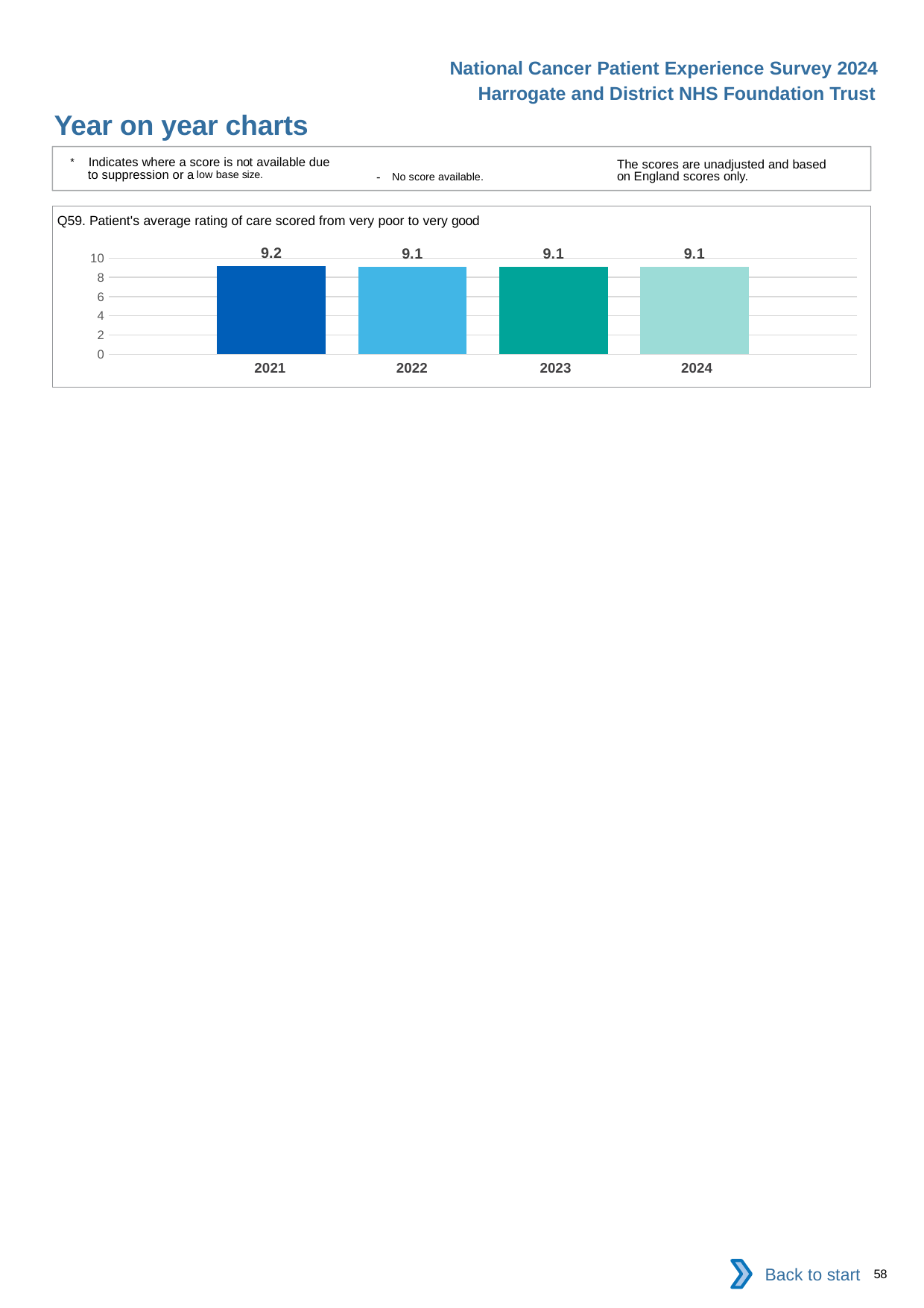
What is the maximum value shown on the y axis? 10 What is the difference between the values for 2021 and 2023? 0.1 What kind of chart is shown? Bar chart Which year has the highest value? 2021 Do the values rise or fall from 2021 to 2022? Fall What is the value for 2022? 9.1 What is the value for 2021? 9.2 What is the title of the chart? Q59. Patient's average rating of care scored from very poor to very good How many years are shown on the x axis? 4 What is the value for 2024? 9.1 Is the value for 2021 greater or less than 8? greater